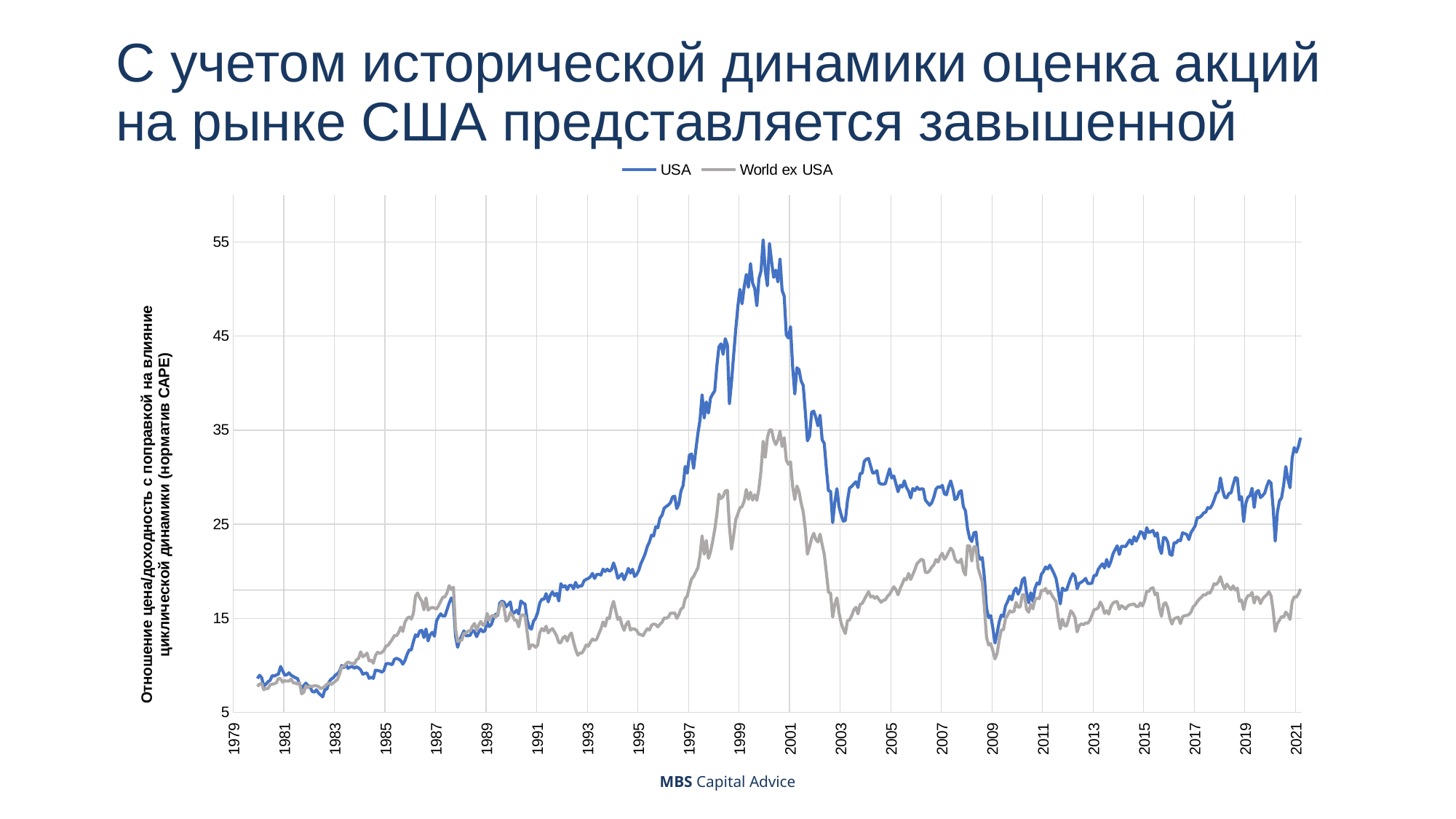
Around 1987, which series has the higher value, USA or World ex USA? World ex USA Is the lowest value of the World ex USA series around 2009 greater or less than 15? less Does the USA series generally rise or fall between 2009 and 2021? rise At the end of the chart (2021), which series has the higher value, USA or World ex USA? USA Is the value of the USA series at the end of the chart (2021) greater or less than 25? greater What kind of chart is shown on the slide? line chart What are the two series named in the legend? USA and World ex USA Is the peak value of the USA series around 2000 greater or less than 45? greater Which series reaches the highest value on the chart? USA What is the first year and the last year labelled on the x axis? 1979 and 2021 How many series does the legend list? 2